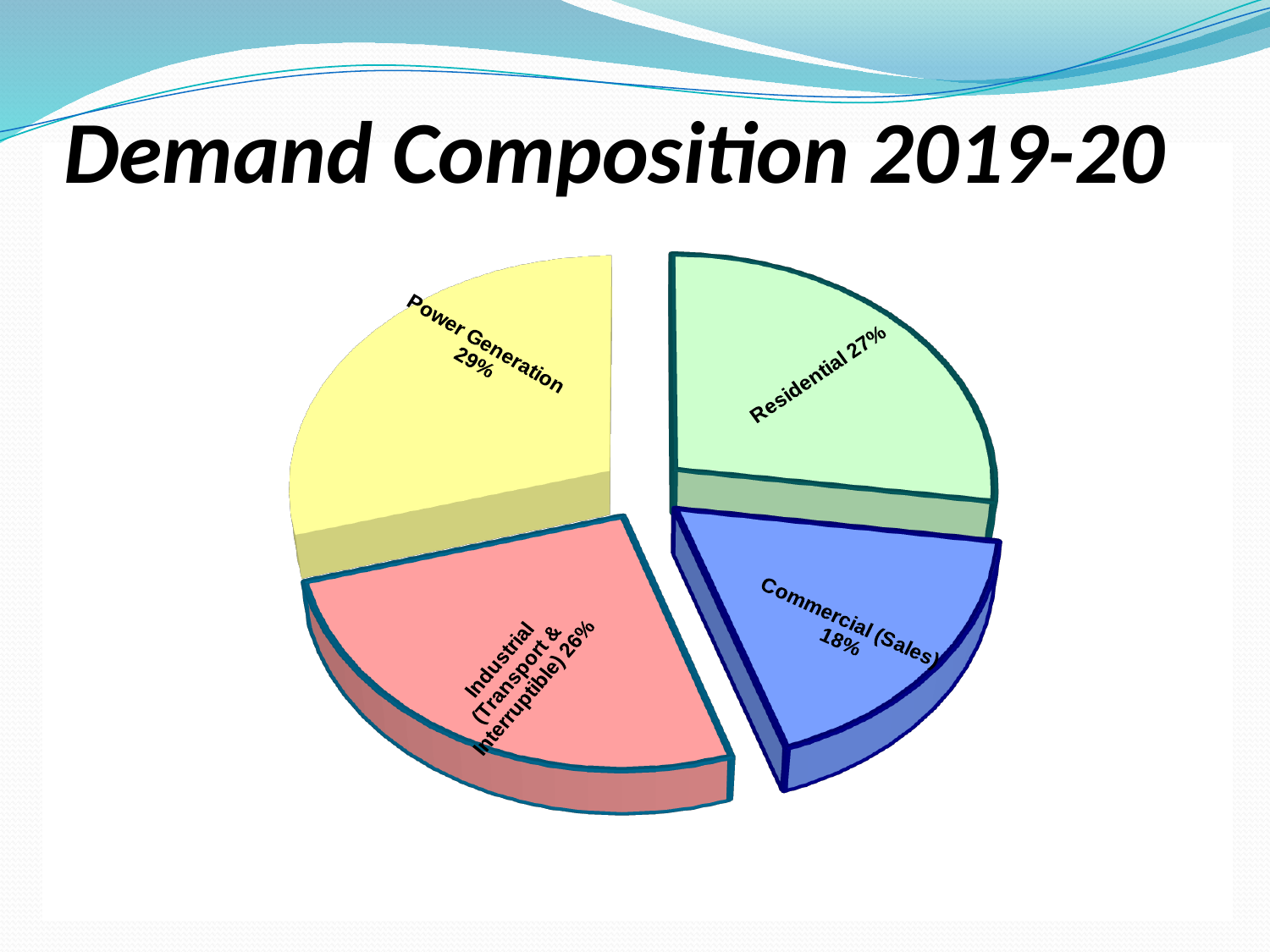
What share of demand does Power Generation account for? 29% Which category has the smallest share of demand? Commercial (Sales) What is the difference in percentage points between Power Generation and Commercial (Sales)? 11 What share of demand does Industrial (Transport & Interruptible) account for? 26% What is the title of the slide containing the chart? Demand Composition 2019-20 What kind of chart is shown on the slide? Pie chart How many categories are shown in the pie chart? 4 Which category has the largest share of demand? Power Generation What colour is the Commercial (Sales) slice? Blue Which is larger, the share for Residential or the share for Industrial (Transport & Interruptible)? Residential What share of demand does Residential account for? 27% What share of demand does Commercial (Sales) account for? 18%